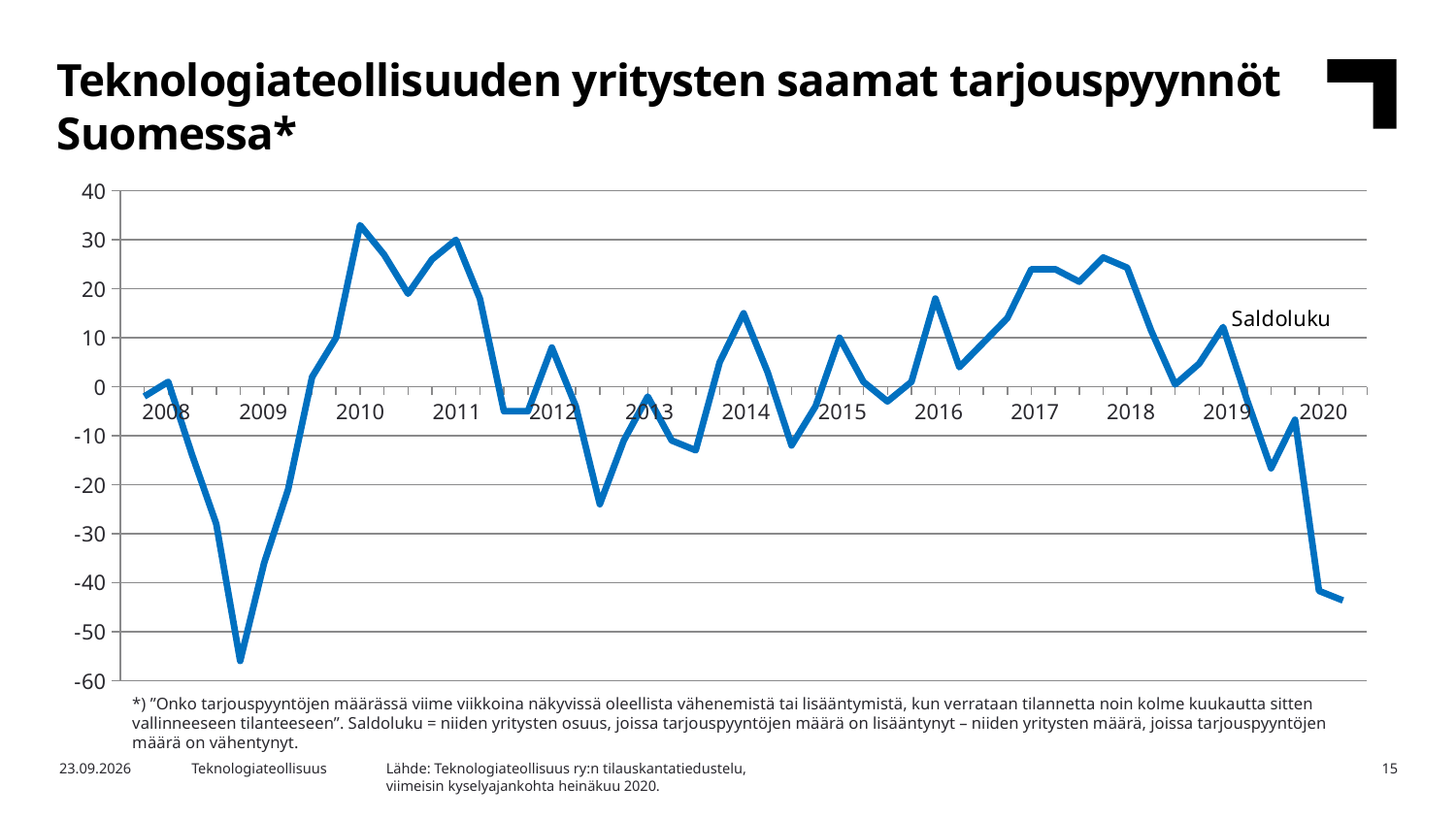
Is the lowest value of the line, reached between 2008 and 2009, greater or less than -50? less Is the peak value of the line in 2010 greater or less than 30? greater Does the line rise or fall between 2018 and 2020? fall What kind of chart is shown on the slide? line chart Is the final value of the line in 2020 greater or less than -40? less What is the name of the series plotted in the chart? Saldoluku How many year labels are shown on the x axis? 13 How many series does the chart plot? 1 What is the title of the chart on the slide? Teknologiateollisuuden yritysten saamat tarjouspyynnöt Suomessa* Does the line rise or fall between 2009 and 2010? rise